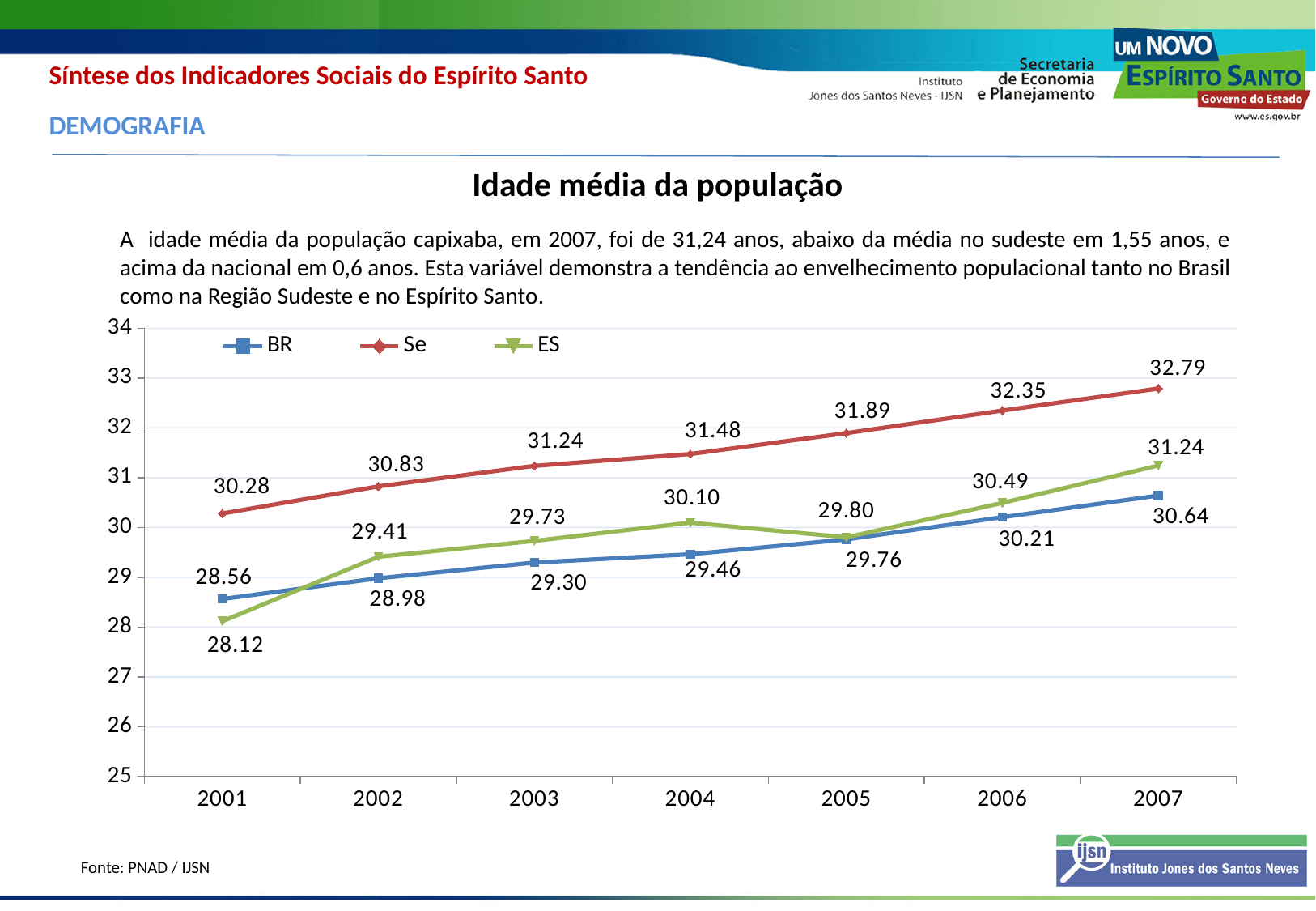
Does the Se series rise or fall from 2001 to 2007? rise What is the title of the chart? Idade média da população What is the value for BR in 2003? 29.30 In 2001, which is larger, the BR value or the ES value? BR What kind of chart is shown on the slide? line chart What is the difference between the Se and ES values in 2007? 1.55 In which year is the ES series at its lowest? 2001 How many series does the legend list? 3 In which year is the Se series at its highest? 2007 What is the value for ES in 2001? 28.12 How many years are plotted along the x axis? 7 What is the value for Se in 2007? 32.79